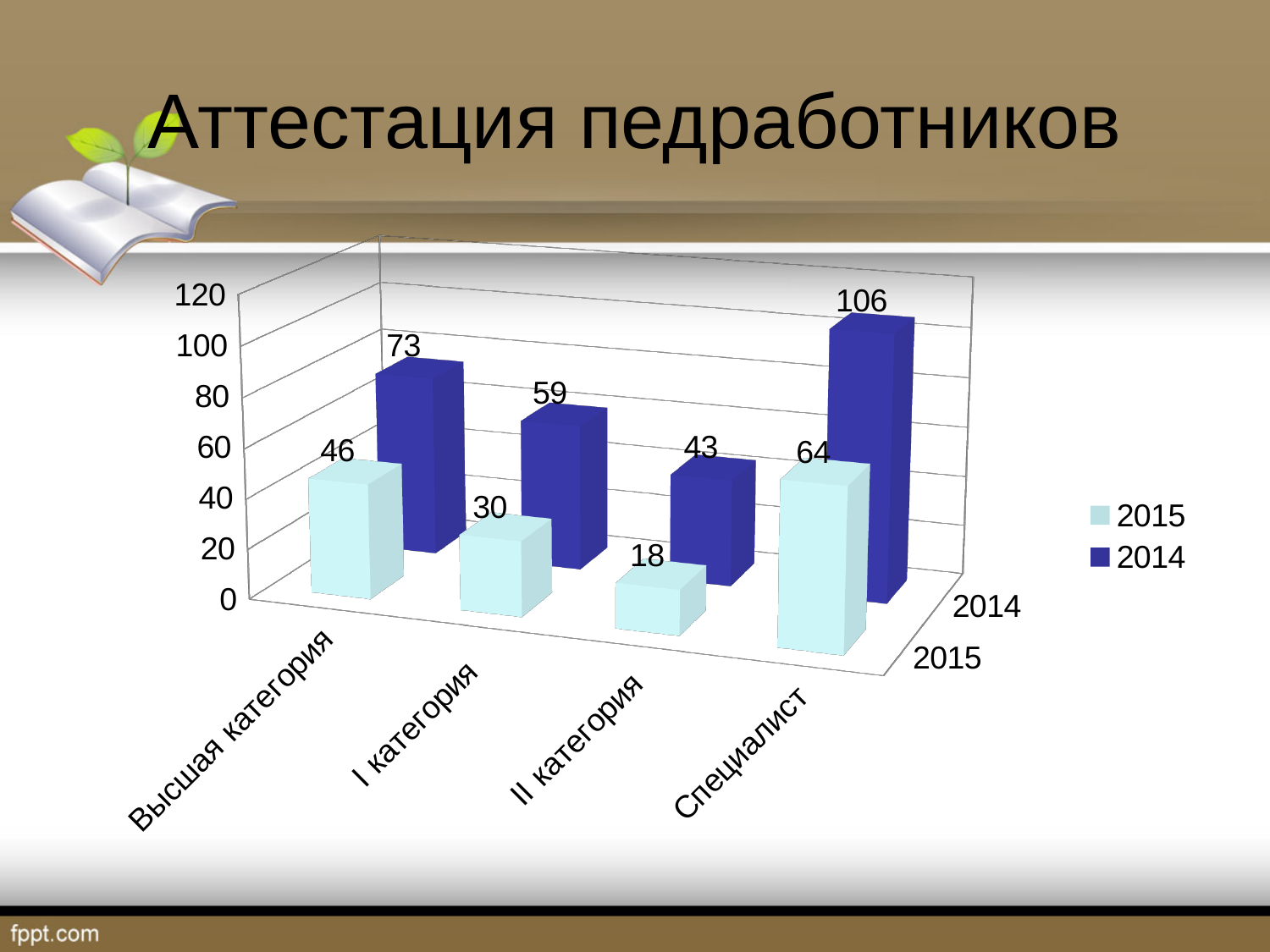
What kind of chart is shown on the slide? Bar chart What is the value for I категория in the 2015 series? 30 How many series does the legend list? 2 Which category has the lowest value in the 2015 series? II категория Which category has the highest value in the 2014 series? Специалист What is the value for Специалист in the 2014 series? 106 What is the value for Высшая категория in the 2014 series? 73 Which is larger for Специалист: the 2014 value or the 2015 value? 2014 What is the difference between the 2014 and 2015 values for Высшая категория? 27 What is the value for II категория in the 2015 series? 18 What is the title of the slide? Аттестация педработников How many categories are shown on the x axis? 4